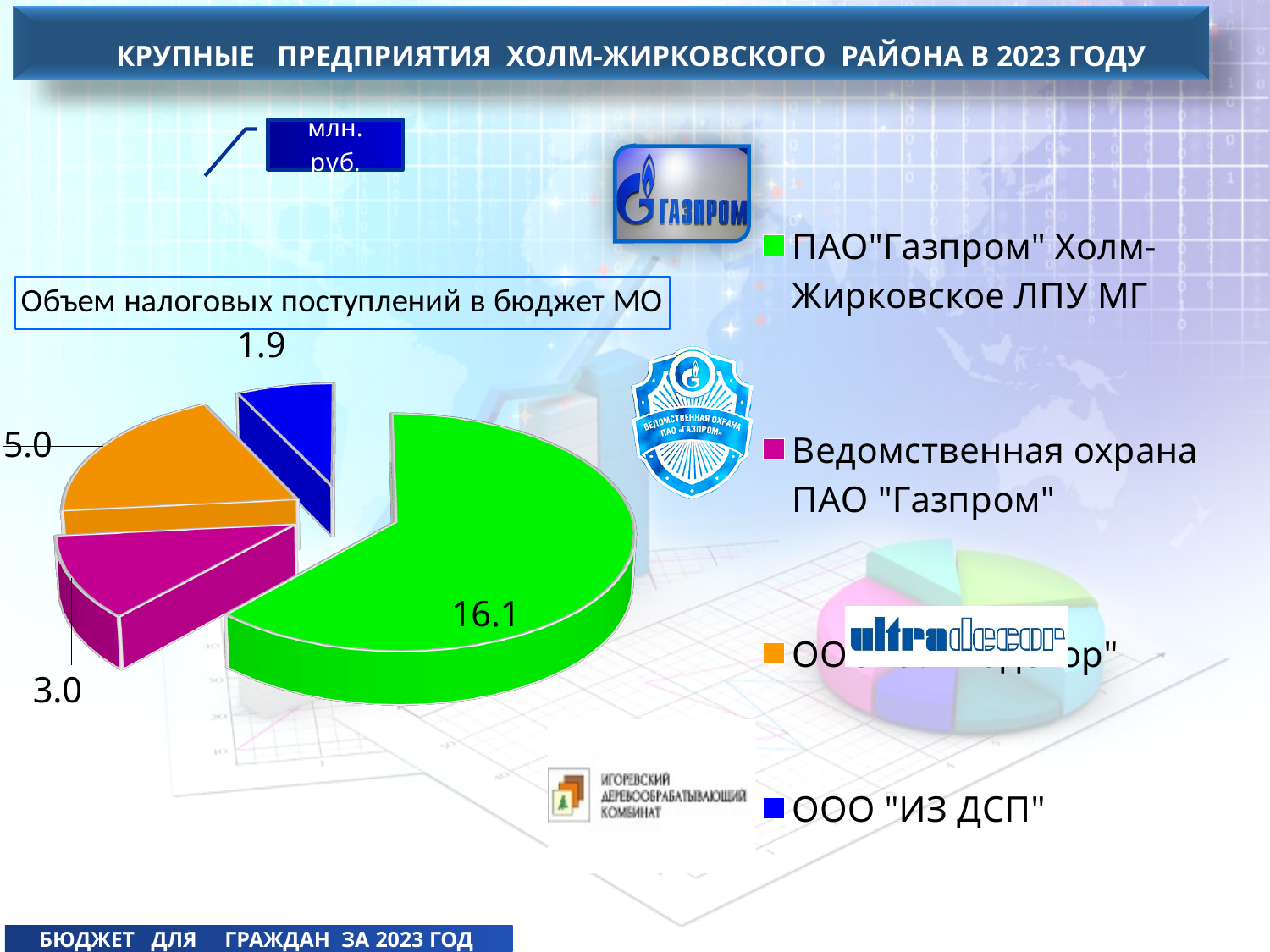
What value is printed next to the orange slice of the pie? 5.0 What kind of chart is shown on the slide? pie chart How many slices does the pie chart have? 4 What unit of measurement is indicated for the chart values? млн. руб. Which enterprise has the smallest slice of the pie? ООО "ИЗ ДСП" What is the difference between the value for ПАО "Газпром" Холм-Жирковское ЛПУ МГ and the value for Ведомственная охрана ПАО "Газпром"? 13.1 What is the title of the chart? Объем налоговых поступлений в бюджет МО Which is larger: the value for Ведомственная охрана ПАО "Газпром" or the value for ООО "ИЗ ДСП"? Ведомственная охрана ПАО "Газпром" What is the value for ПАО "Газпром" Холм-Жирковское ЛПУ МГ? 16.1 What is the value for Ведомственная охрана ПАО "Газпром"? 3.0 Which enterprise has the largest slice of the pie? ПАО "Газпром" Холм-Жирковское ЛПУ МГ What is the value for ООО "ИЗ ДСП"? 1.9